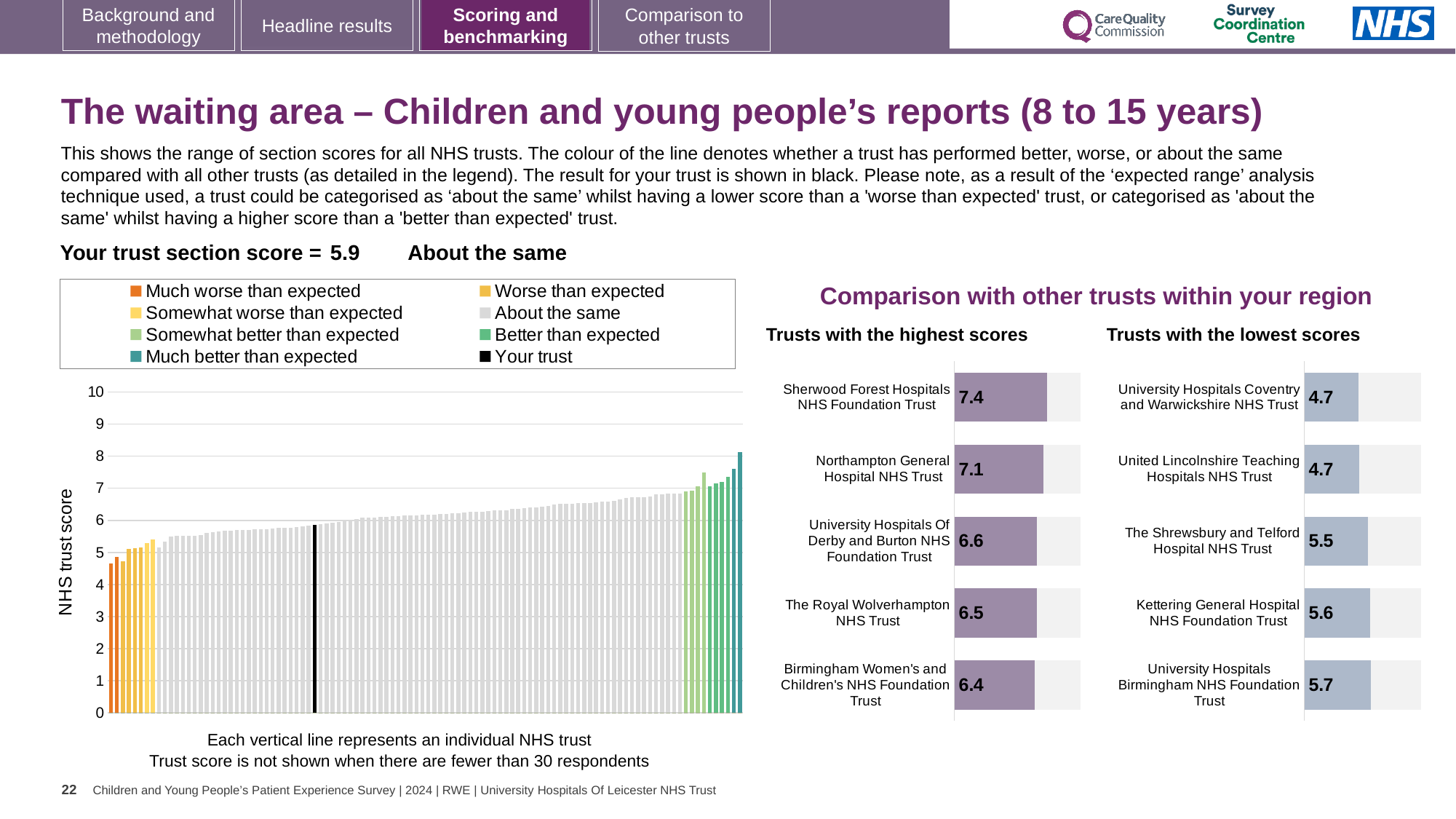
In the NHS trust score chart, do the bar values rise or fall from left to right? Rise How many trusts are listed in the 'Trusts with the lowest scores' chart? 5 In the 'Trusts with the lowest scores' chart, which has the larger score: Kettering General Hospital NHS Foundation Trust or The Shrewsbury and Telford Hospital NHS Trust? Kettering General Hospital NHS Foundation Trust In the 'Trusts with the highest scores' chart, what is the difference between the scores of Sherwood Forest Hospitals NHS Foundation Trust and Birmingham Women's and Children's NHS Foundation Trust? 1.0 In the 'Trusts with the highest scores' chart, which trust has the highest score? Sherwood Forest Hospitals NHS Foundation Trust In the 'Trusts with the highest scores' chart, what is the score for Sherwood Forest Hospitals NHS Foundation Trust? 7.4 In the NHS trust score chart, is the value of the tallest bar greater or less than 7? greater What kind of chart is the NHS trust score chart on the left of the slide? Bar chart In the 'Trusts with the lowest scores' chart, which trust has the highest score? University Hospitals Birmingham NHS Foundation Trust In the 'Trusts with the lowest scores' chart, what is the score for The Shrewsbury and Telford Hospital NHS Trust? 5.5 In the 'Trusts with the highest scores' chart, what is the score for The Royal Wolverhampton NHS Trust? 6.5 How many entries does the legend of the NHS trust score chart list? 8